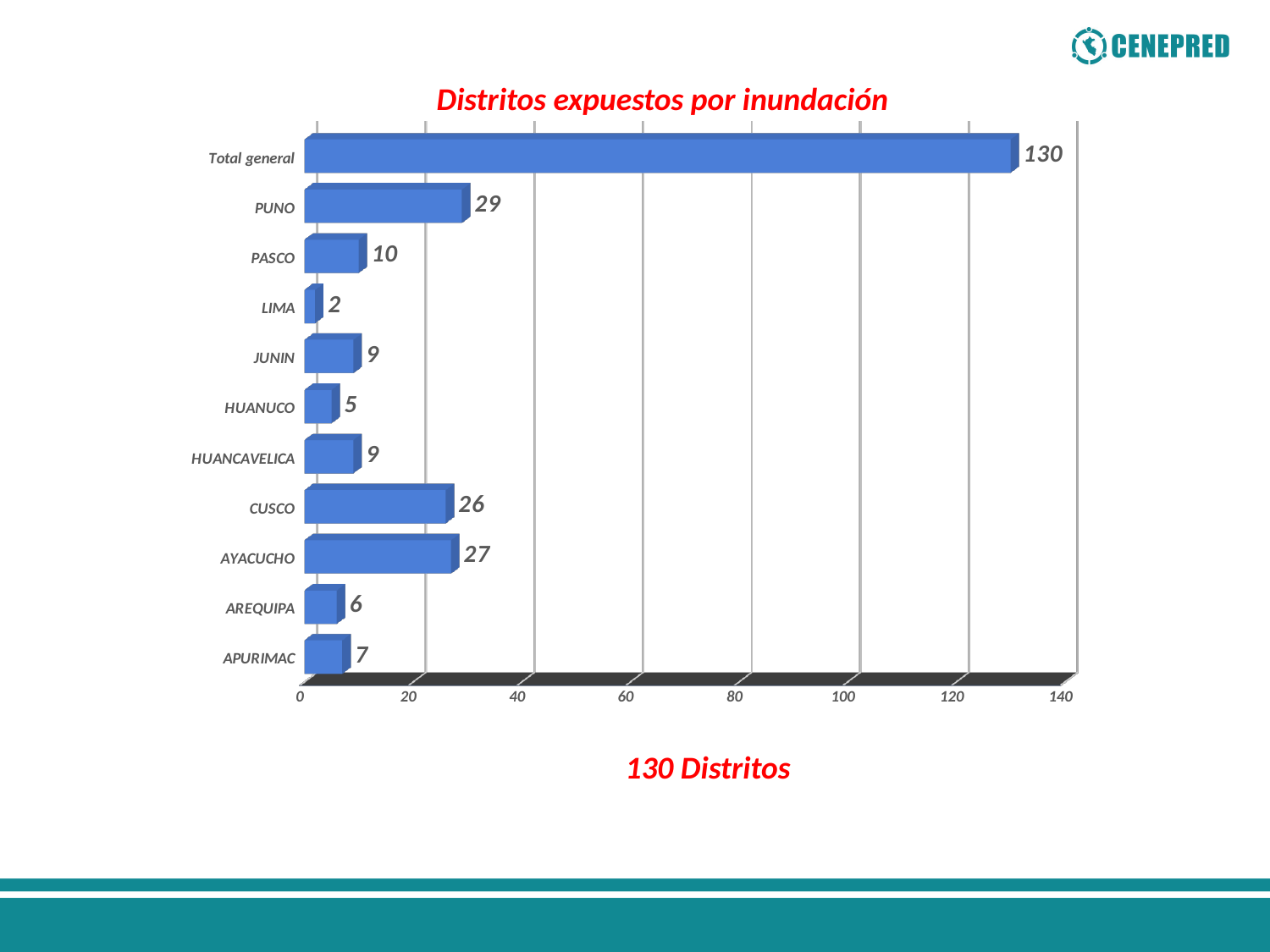
Which category has the lowest value? LIMA What is the value for PUNO? 29 What is the title of the chart? Distritos expuestos por inundación How many categories are shown on the chart, including Total general? 11 Which is larger, the value for PASCO or the value for APURIMAC? PASCO What is the difference between the values for AYACUCHO and CUSCO? 1 What is the value for CUSCO? 26 Excluding Total general, which region has the highest value? PUNO What is the highest value shown on the horizontal axis? 140 What is the value for Total general? 130 What is the value for LIMA? 2 What kind of chart is shown on the slide? Bar chart